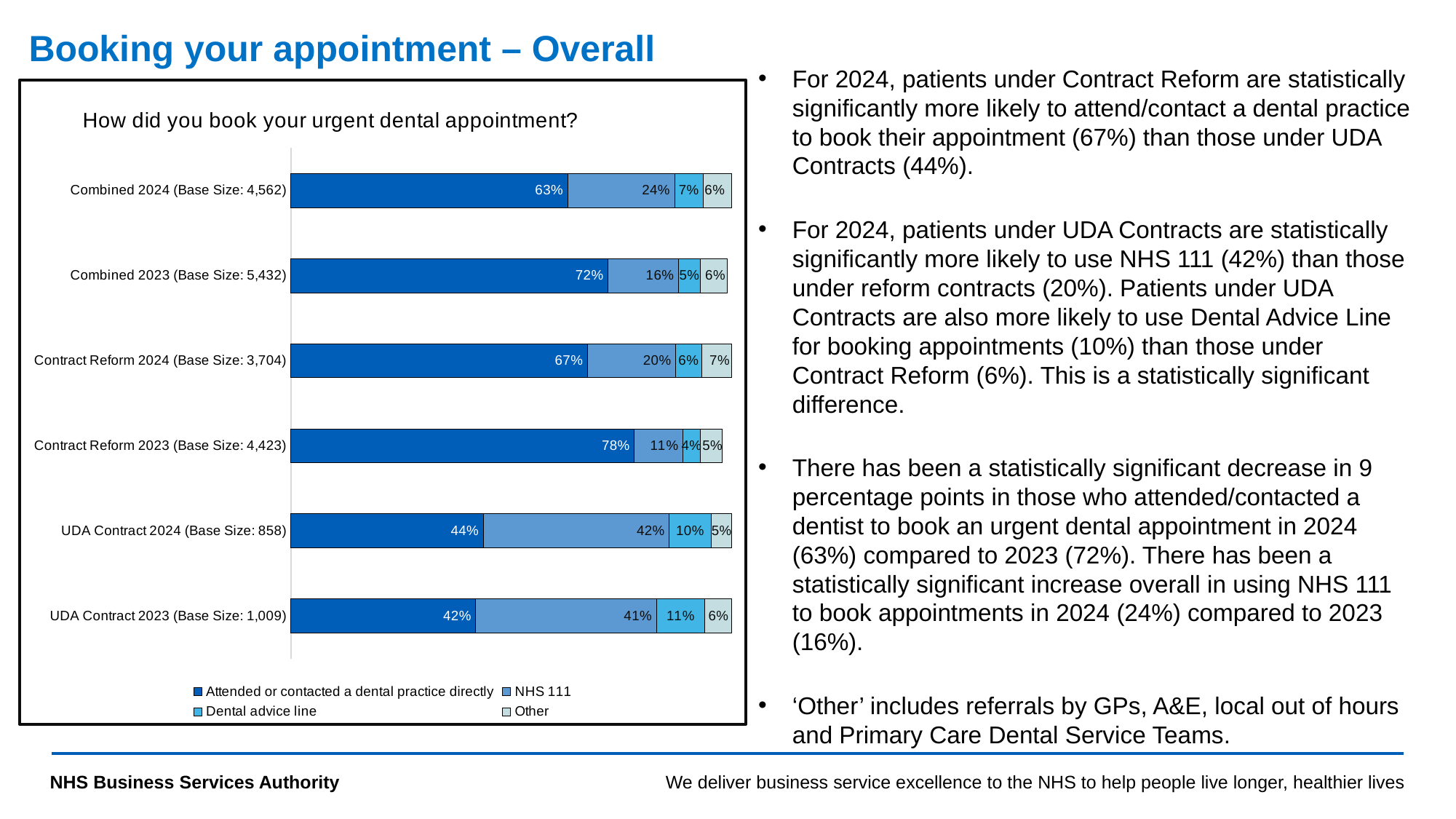
Which is larger: the NHS 111 value for Contract Reform 2024 or for UDA Contract 2024? UDA Contract 2024 What is the title of the chart? How did you book your urgent dental appointment? What type of chart is shown on the slide? Stacked bar chart What percentage of Combined 2024 respondents attended or contacted a dental practice directly? 63% How many categories (bars) are shown in the chart? 6 What is the difference in the 'Attended or contacted a dental practice directly' percentage between Combined 2023 and Combined 2024? 9 percentage points How many series does the legend list? 4 Which category has the highest percentage for 'Attended or contacted a dental practice directly'? Contract Reform 2023 (Base Size: 4,423) What is the Other value for Contract Reform 2024? 7% What percentage of UDA Contract 2024 respondents used NHS 111 to book their urgent dental appointment? 42% Which category has the lowest percentage for NHS 111? Contract Reform 2023 (Base Size: 4,423) What is the Dental advice line value for UDA Contract 2023? 11%